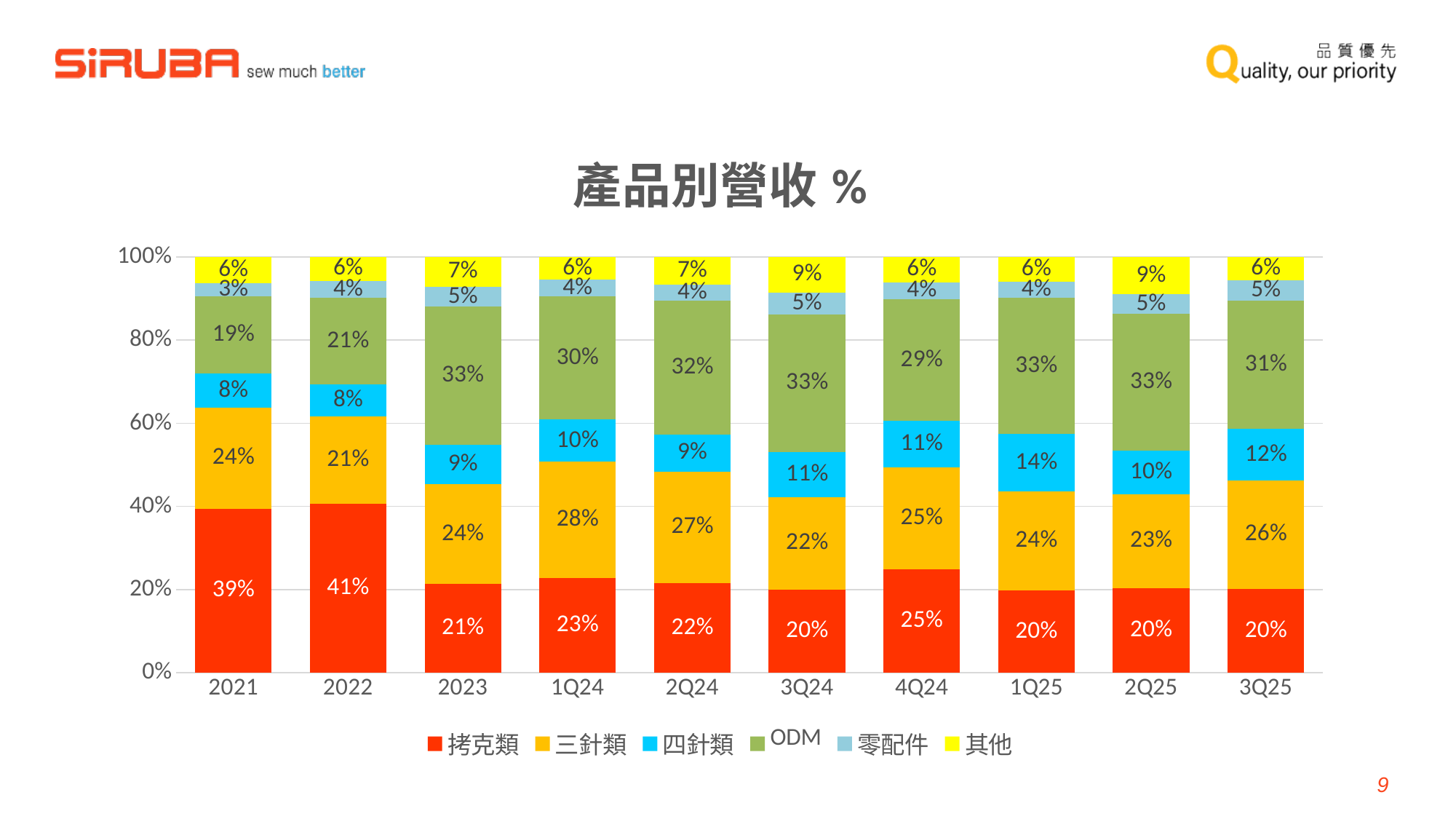
What is the value for ODM in 1Q24? 30% Which is larger: the ODM share in 2021 or in 2023? 2023 What is the value for 四針類 in 1Q25? 14% What kind of chart is shown on the slide? Stacked bar chart What is the value for 三針類 in 3Q25? 26% How many series does the legend list? 6 How many periods are shown on the x axis? 10 What is the value for 拷克類 in 2022? 41% In which period is the 拷克類 share highest? 2022 In which period is the ODM share lowest? 2021 Does the 拷克類 share rise or fall from 2022 to 2023? Fall What is the difference between the 拷克類 share in 2021 and in 2023? 18 percentage points